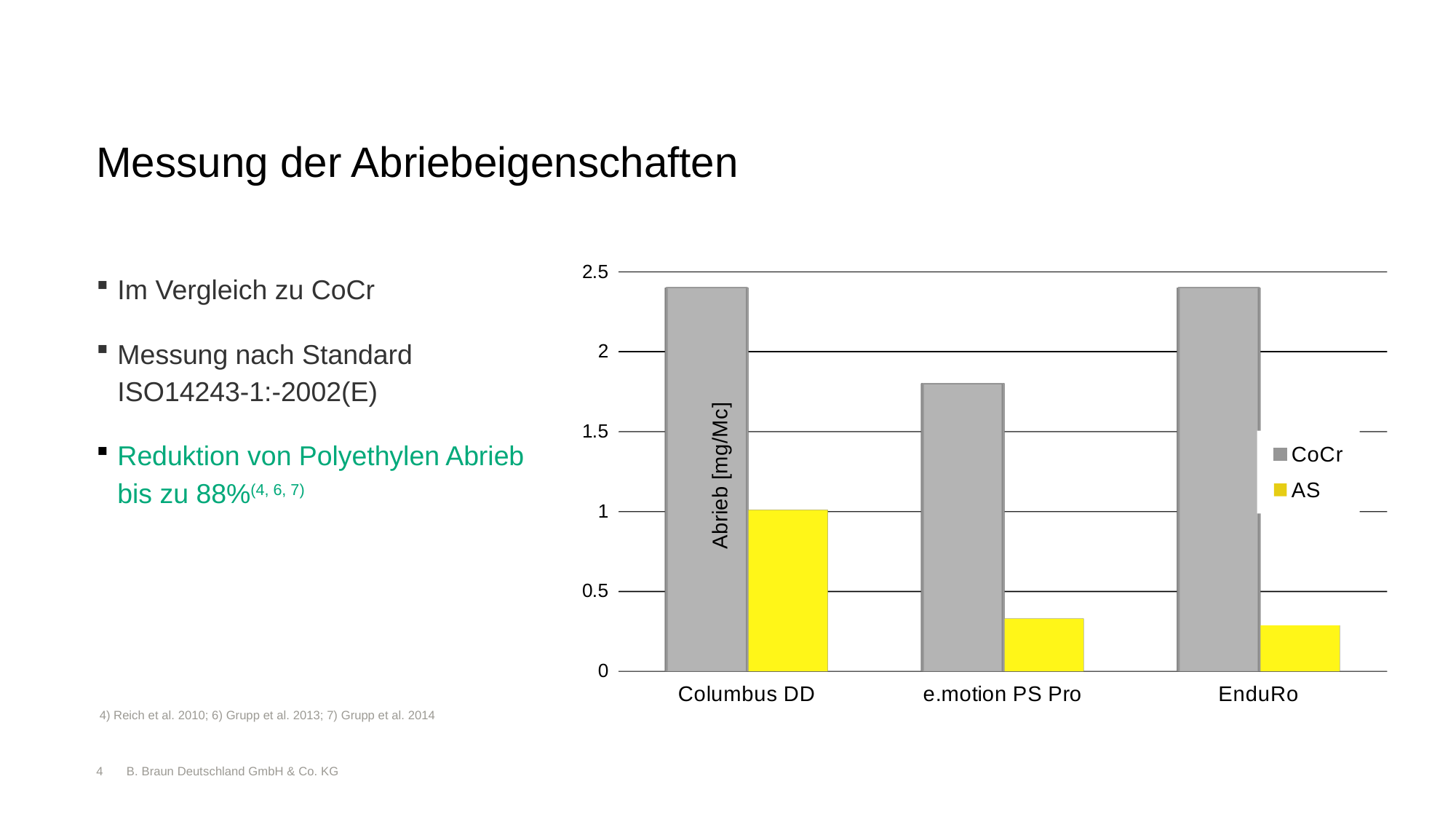
Which category has the lowest CoCr value? e.motion PS Pro For EnduRo, which is larger, the CoCr value or the AS value? CoCr Is the AS value for EnduRo greater or less than 0.5? less Is the CoCr value for Columbus DD greater or less than 2? greater What kind of chart is shown on the slide? bar chart How many categories are shown on the x axis of the chart? 3 How many series does the chart legend list? 2 Is the CoCr value for e.motion PS Pro greater or less than 1.5? greater Which category has the highest AS value? Columbus DD What is the label of the vertical axis of the chart? Abrieb [mg/Mc] Which series is shown in yellow in the chart? AS